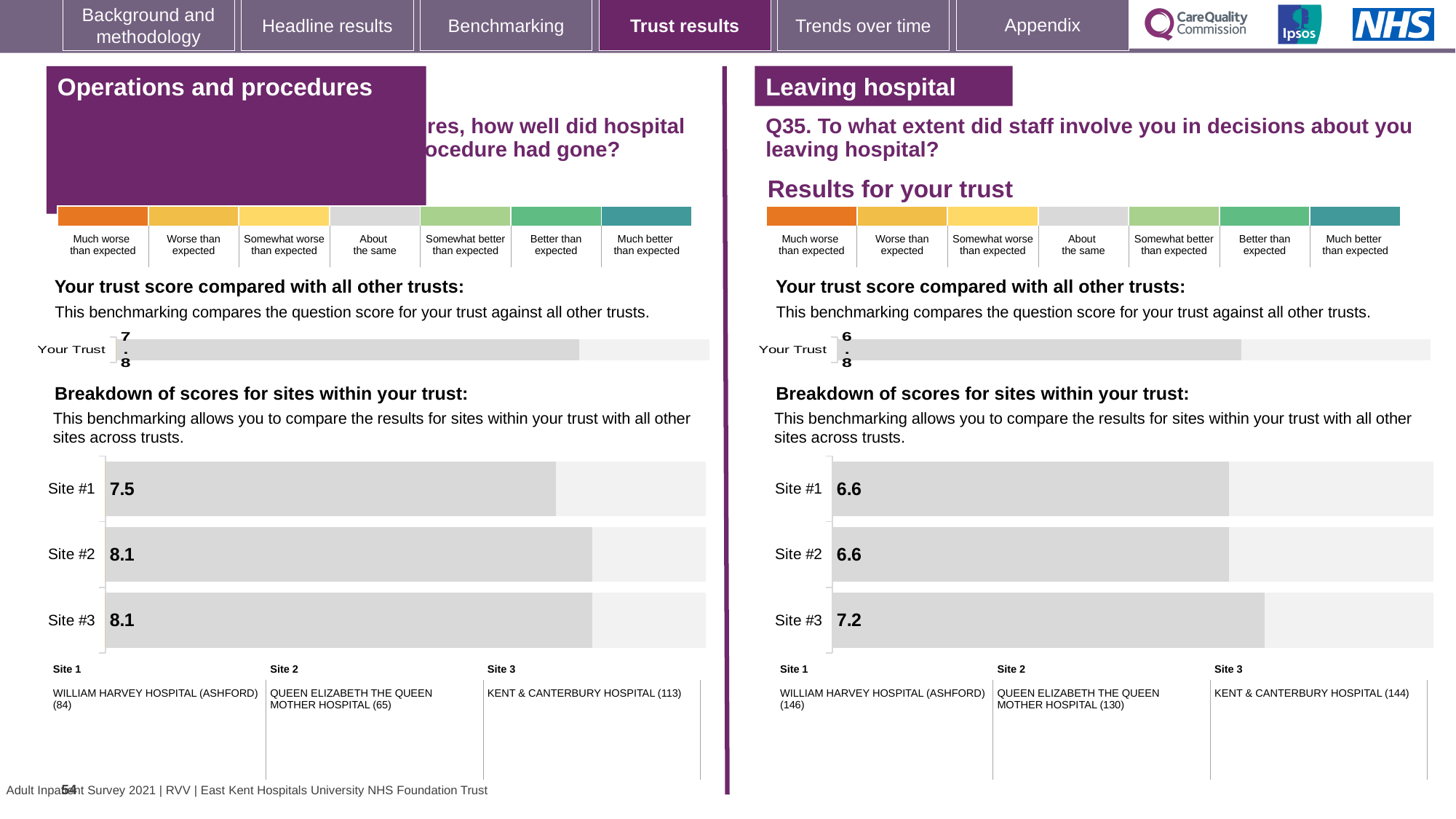
In the 'Leaving hospital' site breakdown chart, what is the difference between the scores for Site #3 and Site #2? 0.6 In the 'Operations and procedures' site breakdown chart, what is the score for Site #2? 8.1 In the 'Leaving hospital' site breakdown chart, what is the score for Site #1? 6.6 In the 'Leaving hospital' site breakdown chart, which site has the highest score? Site #3 In the 'Operations and procedures' site breakdown chart, which site has the lowest score? Site #1 In the 'Operations and procedures' site breakdown chart, what is the difference between the scores for Site #2 and Site #1? 0.6 In the 'Operations and procedures' section, what is the score shown for Your Trust? 7.8 In the 'Leaving hospital' site breakdown chart, what is the score for Site #3? 7.2 In the 'Operations and procedures' site breakdown chart, what is the score for Site #1? 7.5 How many sites are shown in the 'Leaving hospital' site breakdown chart? 3 In the 'Leaving hospital' section, what is the score shown for Your Trust? 6.8 What type of chart is used for the site breakdown in the 'Operations and procedures' section? Bar chart